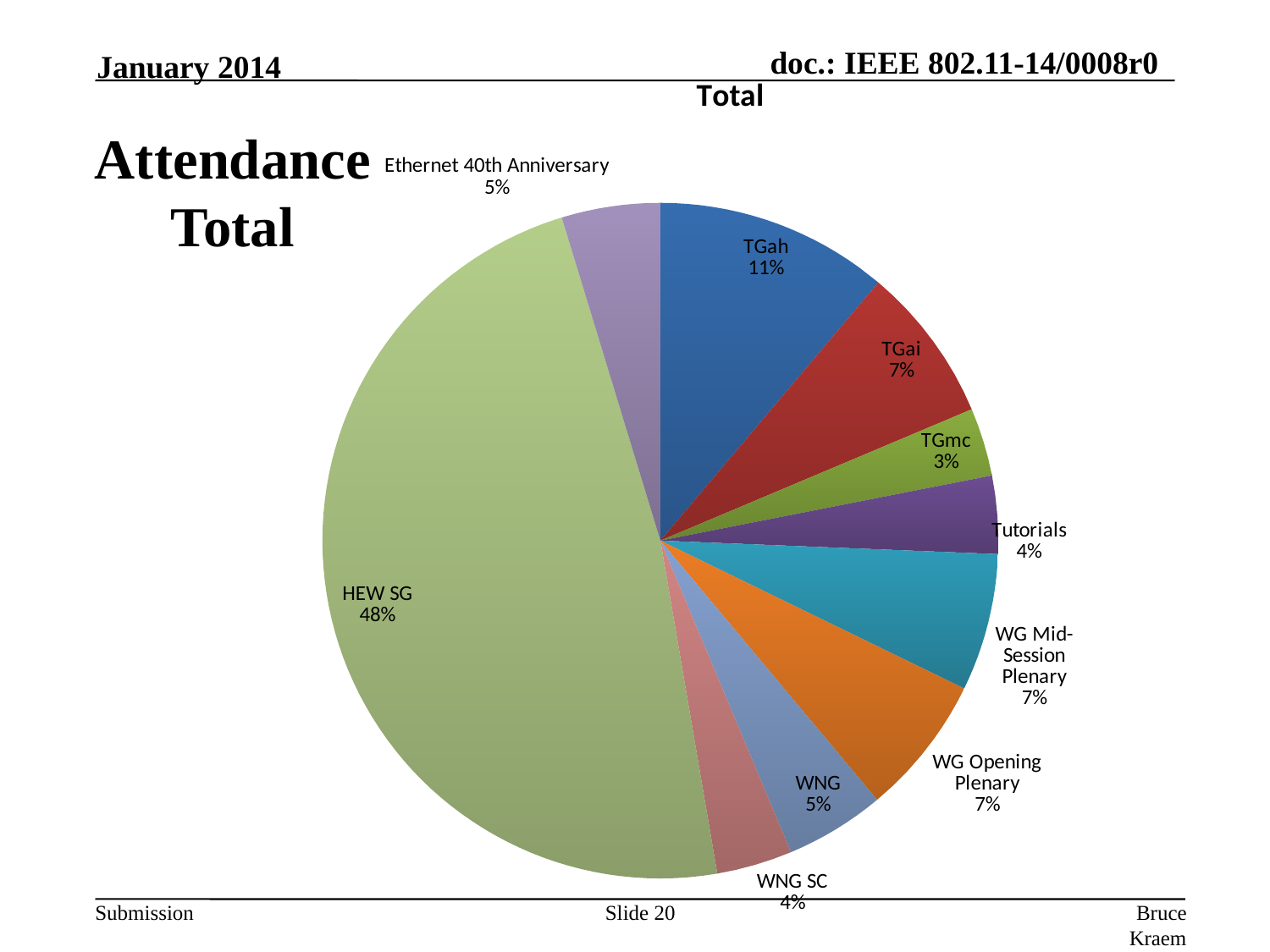
What share of the pie does TGah have? 11% Which is larger, the share for TGai or the share for WNG SC? TGai What is the title of the chart? Total Which slice is the largest in the pie chart? HEW SG How many slices does the pie chart have? 10 What is the difference between the shares of HEW SG and TGah? 37% What share of the pie does TGmc have? 3% What kind of chart is shown on the slide? pie chart What share of the pie does WG Mid-Session Plenary have? 7% Which slice is the smallest in the pie chart? TGmc